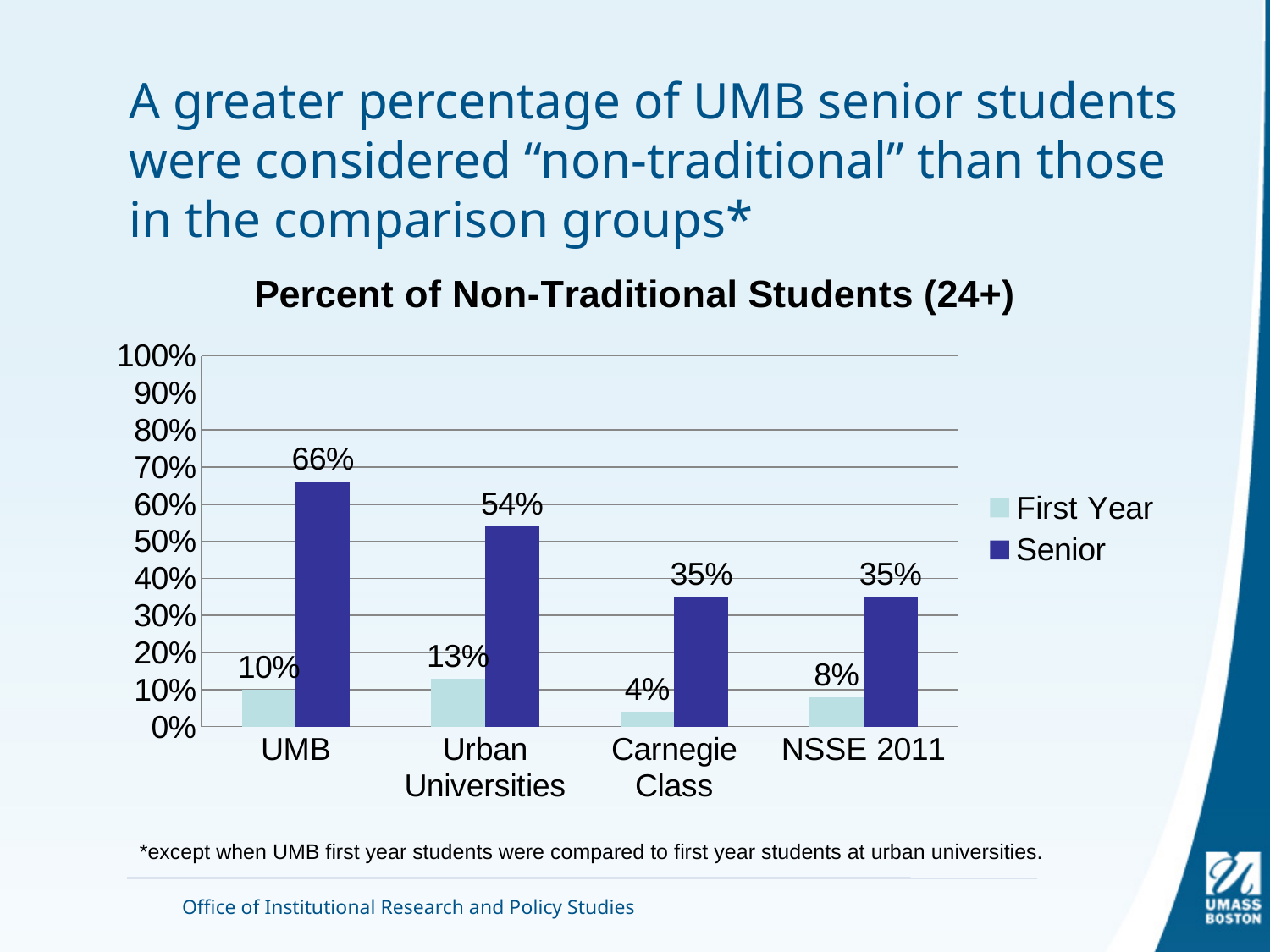
What kind of chart is shown? bar chart How many categories are shown on the x axis? 4 Which category has the lowest First Year value? Carnegie Class How many series does the legend list? 2 Is the Senior value for Urban Universities greater or less than 50%? greater What is the Senior value for UMB? 66% Which is larger, the First Year value for UMB or the First Year value for Urban Universities? Urban Universities What is the First Year value for Carnegie Class? 4% What is the First Year value for Urban Universities? 13% What is the difference between the Senior and First Year values for UMB? 56% Which category has the highest Senior value? UMB What is the title of the chart? Percent of Non-Traditional Students (24+)